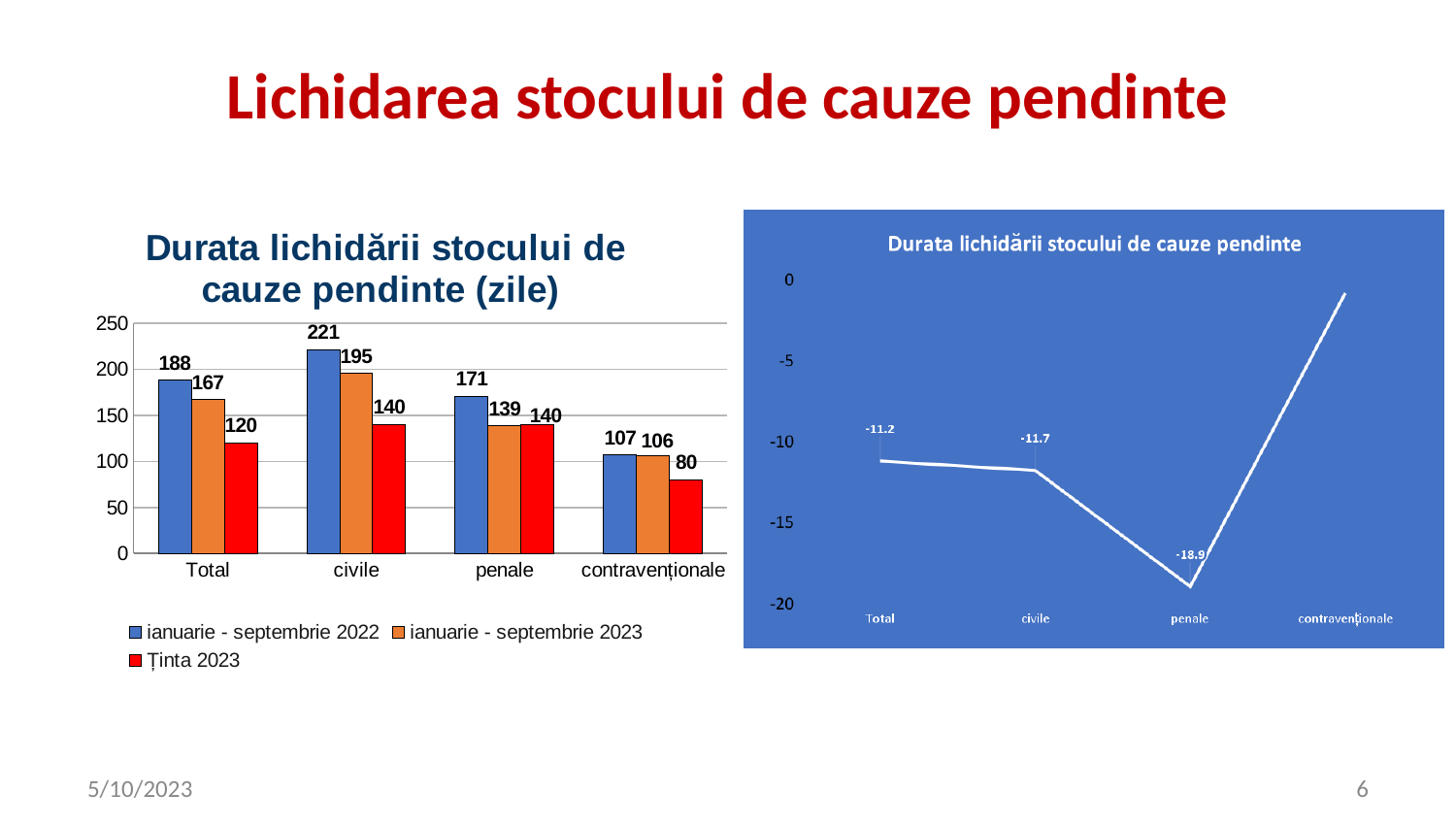
How many categories are shown on the x axis of the left bar chart 'Durata lichidării stocului de cauze pendinte (zile)'? 4 In the left bar chart 'Durata lichidării stocului de cauze pendinte (zile)', which is larger for 'penale': the 'ianuarie - septembrie 2023' value or the 'Ținta 2023' value? Ținta 2023 In the right line chart 'Durata lichidării stocului de cauze pendinte', is the value for 'contravenționale' greater or less than -5? greater In the left bar chart 'Durata lichidării stocului de cauze pendinte (zile)', what is the 'Ținta 2023' value for 'contravenționale'? 80 In the left bar chart 'Durata lichidării stocului de cauze pendinte (zile)', which category has the highest value in the series 'ianuarie - septembrie 2022'? civile In the left bar chart 'Durata lichidării stocului de cauze pendinte (zile)', what is the difference between the 'ianuarie - septembrie 2022' and 'ianuarie - septembrie 2023' values for 'Total'? 21 In the left bar chart 'Durata lichidării stocului de cauze pendinte (zile)', which category has the lowest 'Ținta 2023' value? contravenționale In the left bar chart 'Durata lichidării stocului de cauze pendinte (zile)', what is the value for 'civile' in the series 'ianuarie - septembrie 2022'? 221 In the right line chart 'Durata lichidării stocului de cauze pendinte', what is the value for 'penale'? -18.9 How many series does the legend of the left bar chart 'Durata lichidării stocului de cauze pendinte (zile)' list? 3 What kind of chart is the chart on the right side of the slide, 'Durata lichidării stocului de cauze pendinte'? line chart In the left bar chart 'Durata lichidării stocului de cauze pendinte (zile)', what is the value for 'penale' in the series 'ianuarie - septembrie 2023'? 139